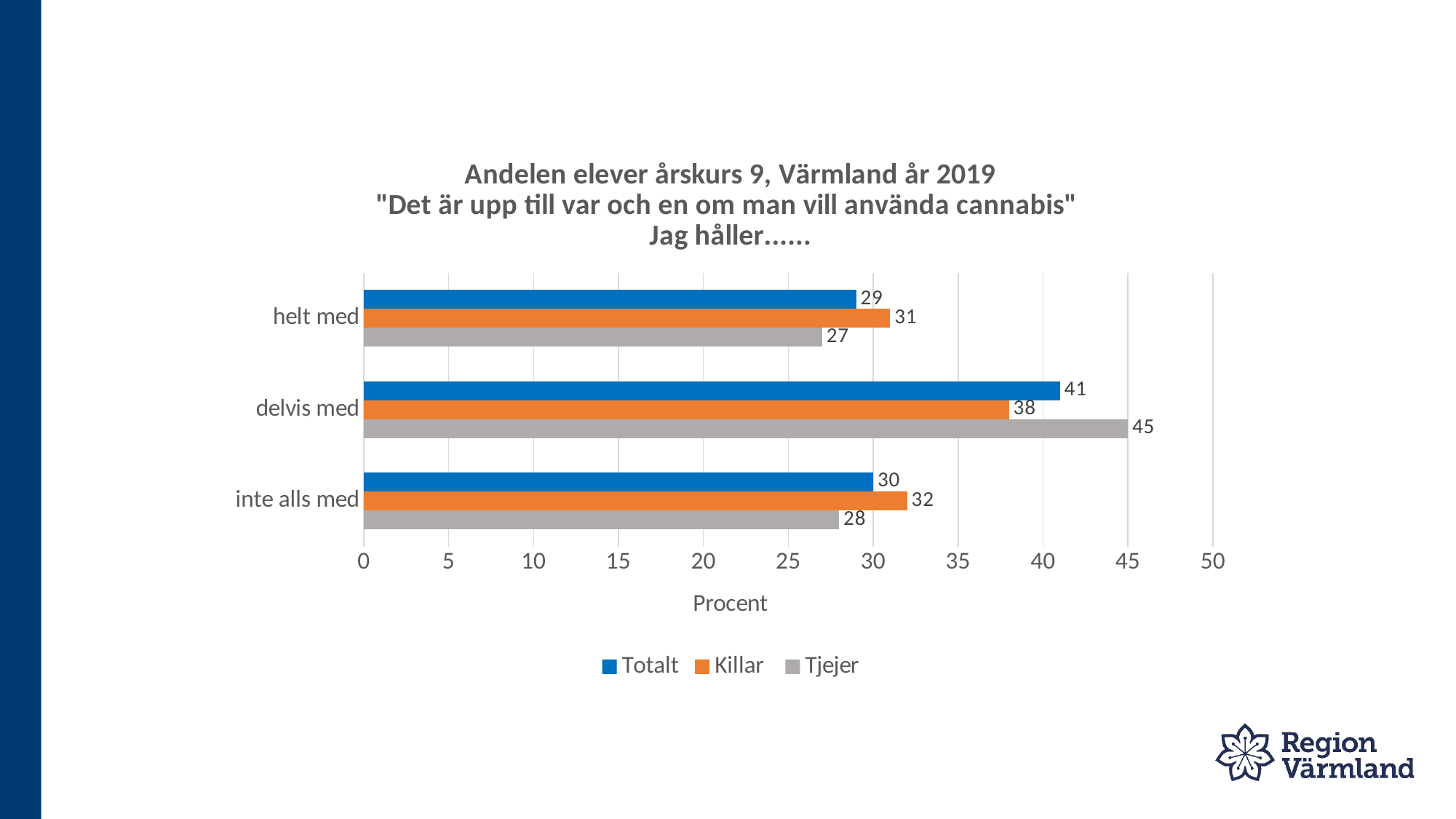
Which is larger in the 'helt med' category, Killar or Tjejer? Killar What is the difference between the Tjejer and Killar values in the 'delvis med' category? 7 How many series does the legend list? 3 Which category has the highest value for Tjejer? delvis med What is the value for Tjejer in the 'helt med' category? 27 How many categories are shown on the vertical axis? 3 Which category has the lowest value for Killar? helt med What kind of chart is shown on the slide? bar chart What is the value for Totalt in the 'delvis med' category? 41 What is the label of the horizontal axis? Procent Is the value for Tjejer in 'delvis med' greater or less than 40? greater What is the value for Killar in the 'inte alls med' category? 32